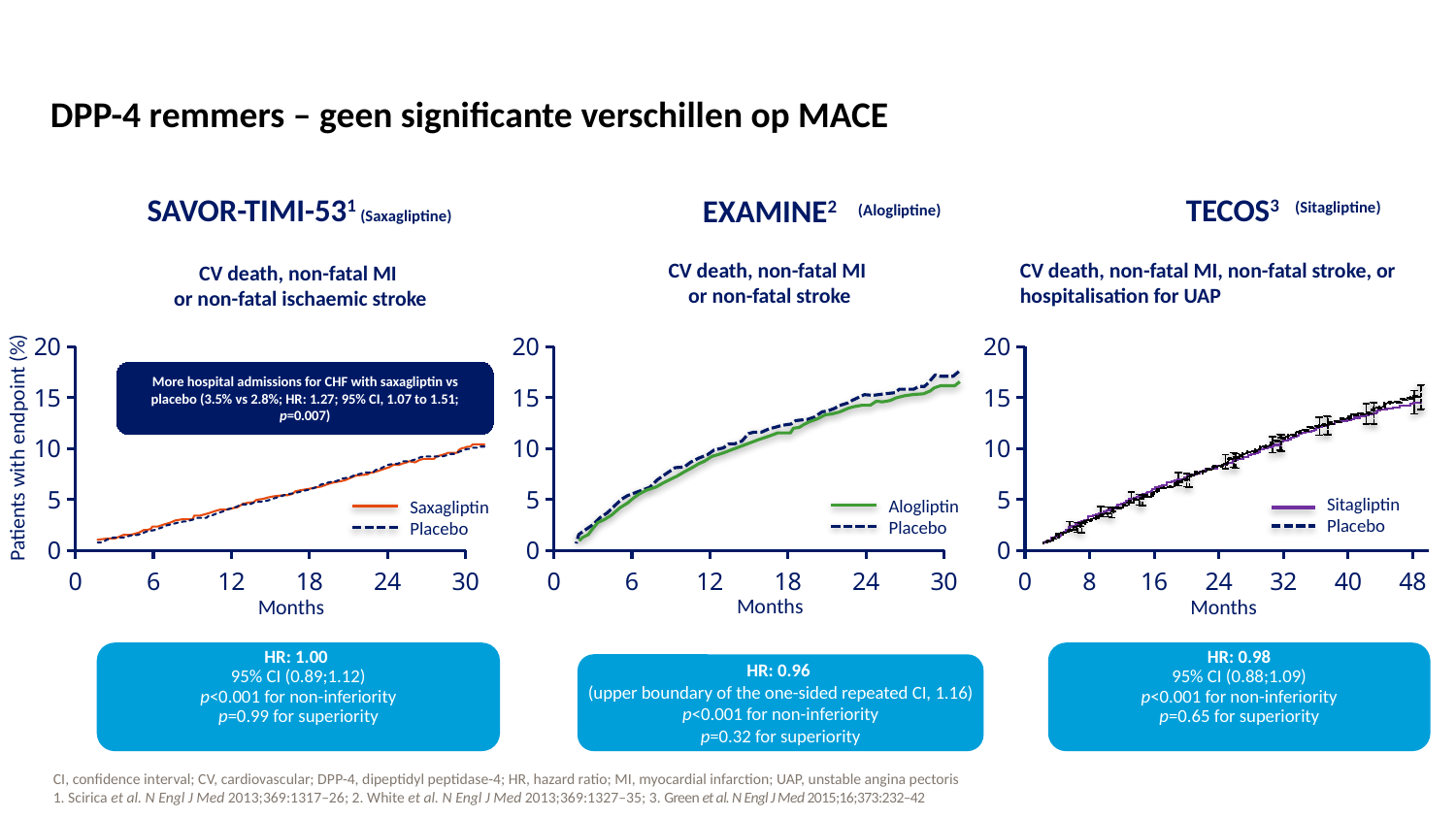
Which two series are shown in the legend of the TECOS chart? Sitagliptin and Placebo In the EXAMINE chart, do the curves rise or fall as months increase? Rise How many series does the legend of the EXAMINE chart list? 2 In the SAVOR-TIMI-53 chart, is the value for Saxagliptin at 30 months greater or less than 15? less In the TECOS chart, is the value for Sitagliptin at 48 months greater or less than 10? greater How many tick marks are labelled on the x axis of the SAVOR-TIMI-53 chart? 6 What kind of chart is the SAVOR-TIMI-53 chart on the left? Line chart In the EXAMINE chart, is the value for Placebo at 30 months greater or less than 15? greater In the EXAMINE chart, which series is higher at 30 months, Alogliptin or Placebo? Placebo What is the highest value shown on the y axis of the TECOS chart? 20 How many tick marks are labelled on the x axis of the TECOS chart? 7